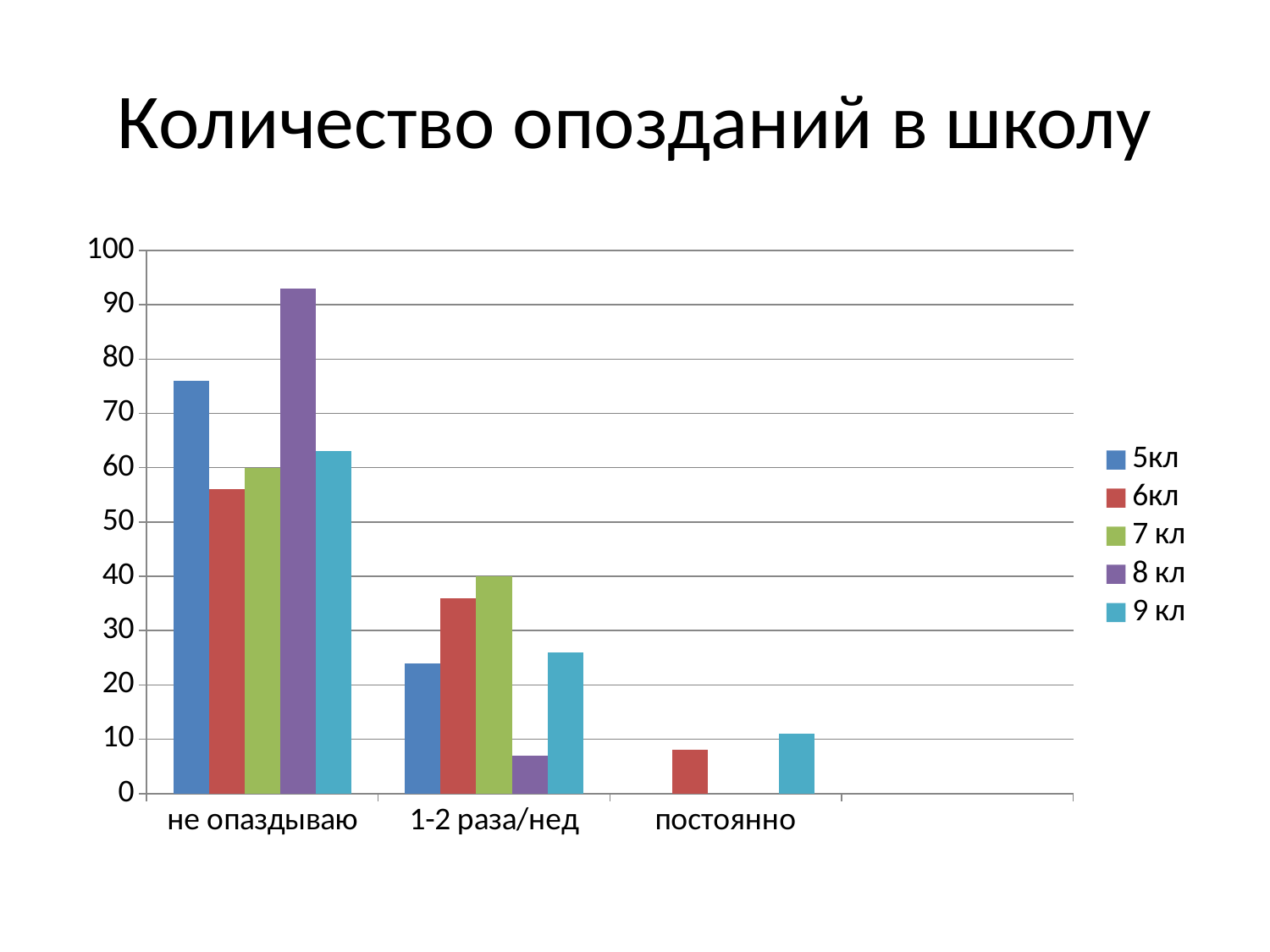
Which series has the highest value in the category "не опаздываю"? 8 кл Is the value for 9 кл in the category "постоянно" greater or less than 20? less What is the title of the chart? Количество опозданий в школу Is the value for 5кл in the category "не опаздываю" greater or less than 70? greater What is the value for 7 кл in the category "1-2 раза/нед"? 40 In the category "1-2 раза/нед", which is larger: the value for 6кл or the value for 5кл? 6кл How many series does the legend list? 5 How many categories are shown on the x axis? 3 Which series is shown in purple in the legend? 8 кл What kind of chart is shown on the slide? bar chart What is the value for 7 кл in the category "не опаздываю"? 60 Which series has the lowest value in the category "1-2 раза/нед"? 8 кл